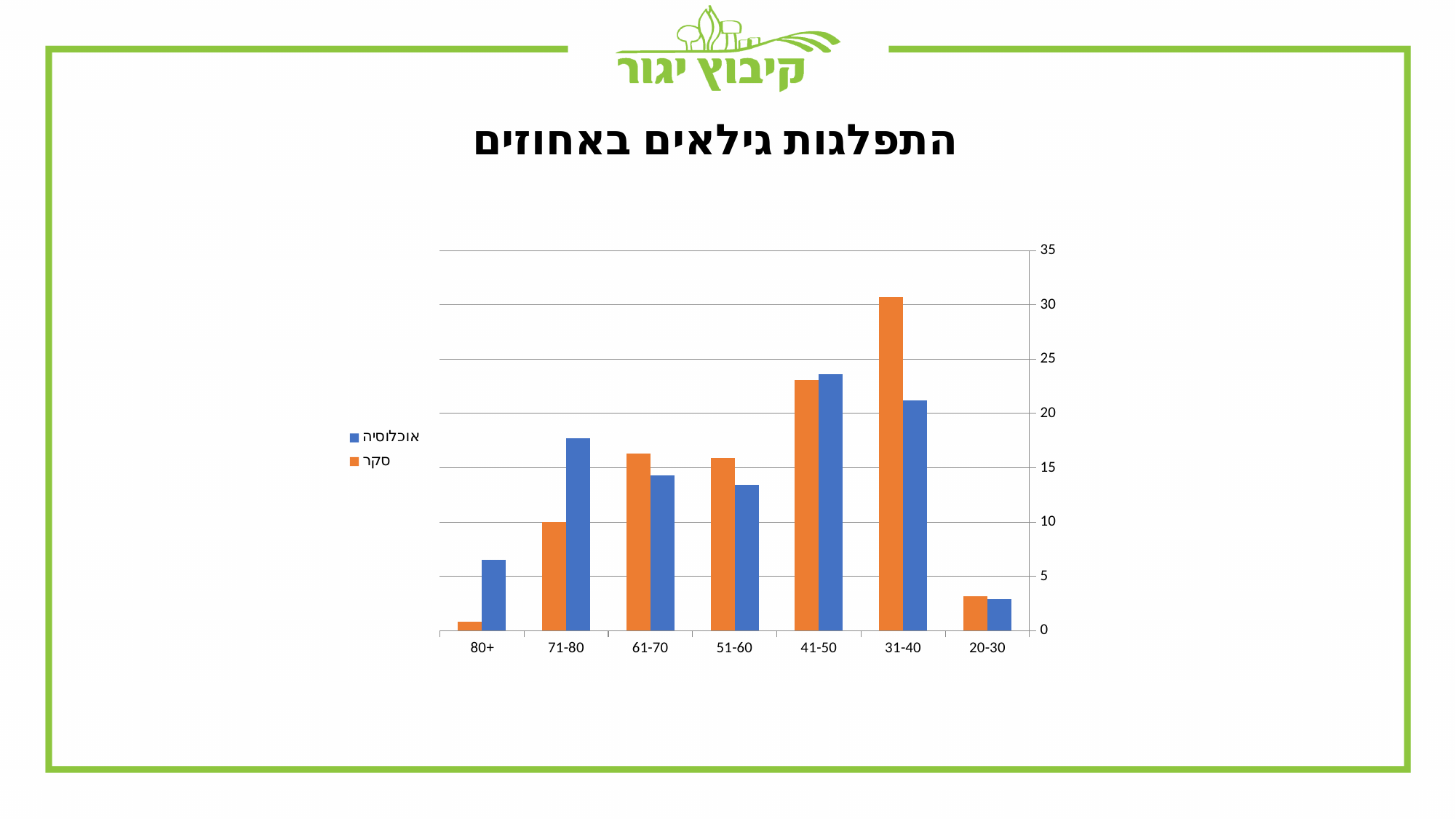
For the 31-40 category, which series has the larger value, אוכלוסיה or סקר? סקר How many age categories are shown on the x axis? 7 What kind of chart is shown on the slide? bar chart Which age category has the lowest value for the אוכלוסיה series? 20-30 Which age category has the lowest value for the סקר series? 80+ Which age category has the highest value for the סקר series? 31-40 Is the אוכלוסיה value for 80+ greater or less than 10? less Which age category has the highest value for the אוכלוסיה series? 41-50 What is the title of the chart? התפלגות גילאים באחוזים Is the סקר value for 31-40 greater or less than 25? greater For the 71-80 category, which series has the larger value, אוכלוסיה or סקר? אוכלוסיה How many series does the legend list? 2